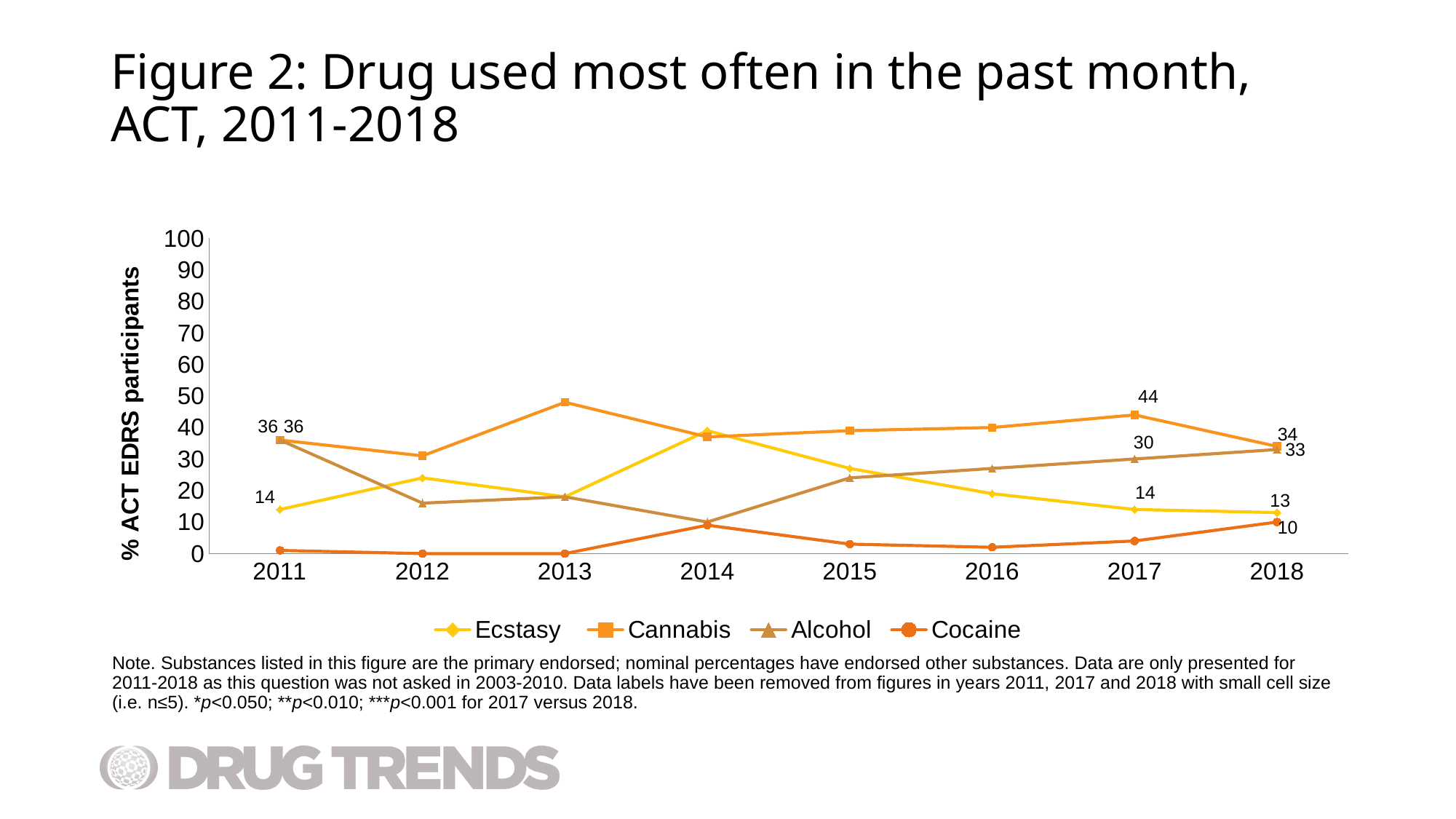
Which drug has the lowest value in 2017? Cocaine Does the Ecstasy line rise or fall from 2014 to 2018? fall What is the value for Cannabis in 2017? 44 What is the value for Cocaine in 2018? 10 What is the value for Ecstasy in 2011? 14 How many series does the legend list? 4 What kind of chart is shown on the slide? line chart How many years are plotted along the x axis? 8 Which drug has the highest value in 2017? Cannabis What is the value for Alcohol in 2017? 30 Is the value for Cannabis in 2013 greater or less than 40? greater What is the difference between the Cannabis and Alcohol values in 2017? 14